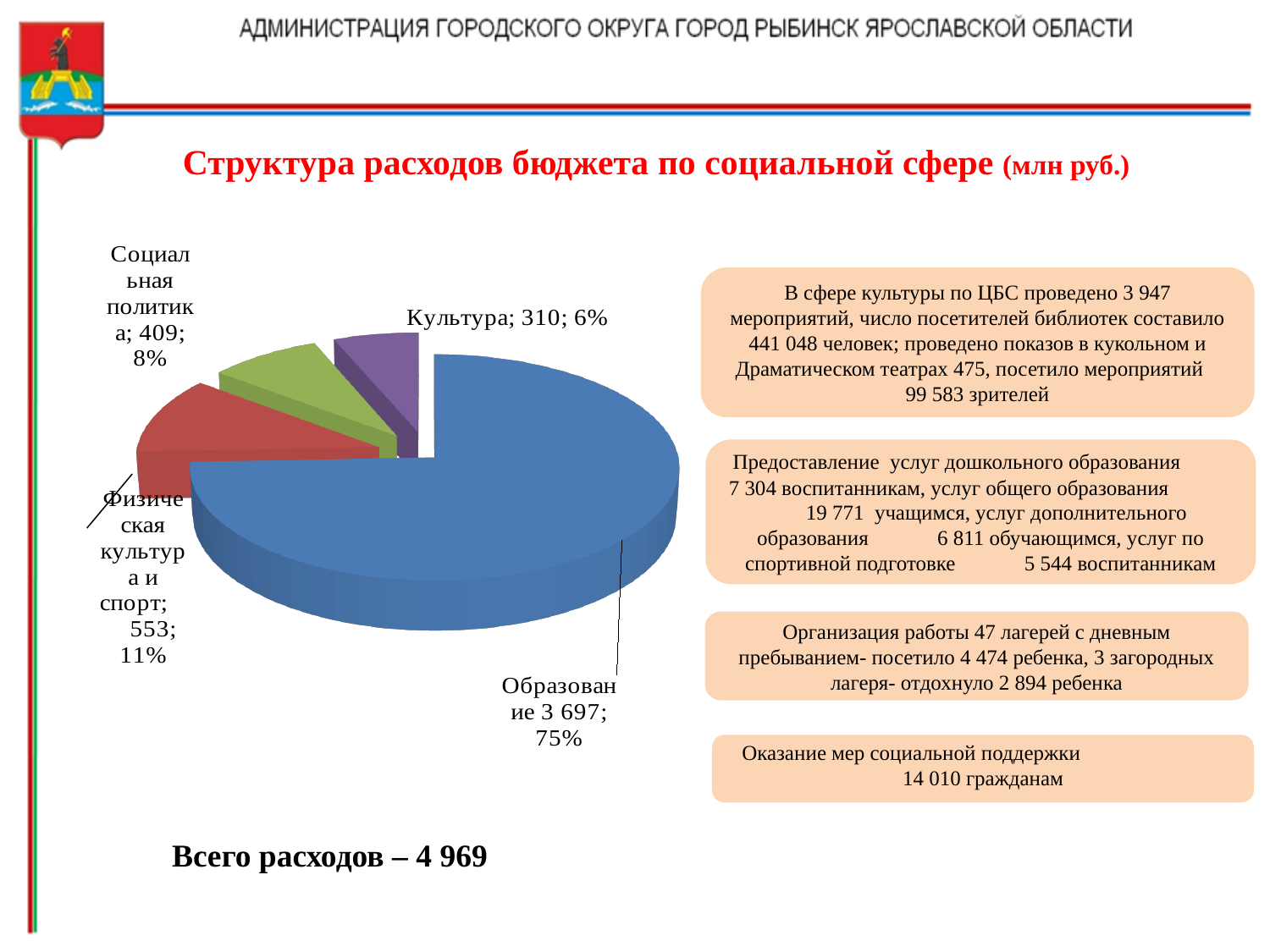
What is the value for Культура in the pie chart? 310 Which is larger, the value for Социальная политика or the value for Культура? Социальная политика What is the difference between the values for Физическая культура и спорт and Культура? 243 What percentage share does Социальная политика have in the pie chart? 8% What kind of chart is shown on the slide? Pie chart Which category has the largest share of the pie chart? Образование What is the value for Образование in the pie chart? 3 697 What is the value for Социальная политика in the pie chart? 409 Which category has the smallest share of the pie chart? Культура What percentage share does Физическая культура и спорт have in the pie chart? 11% How many slices does the pie chart have? 4 What is the value for Физическая культура и спорт in the pie chart? 553